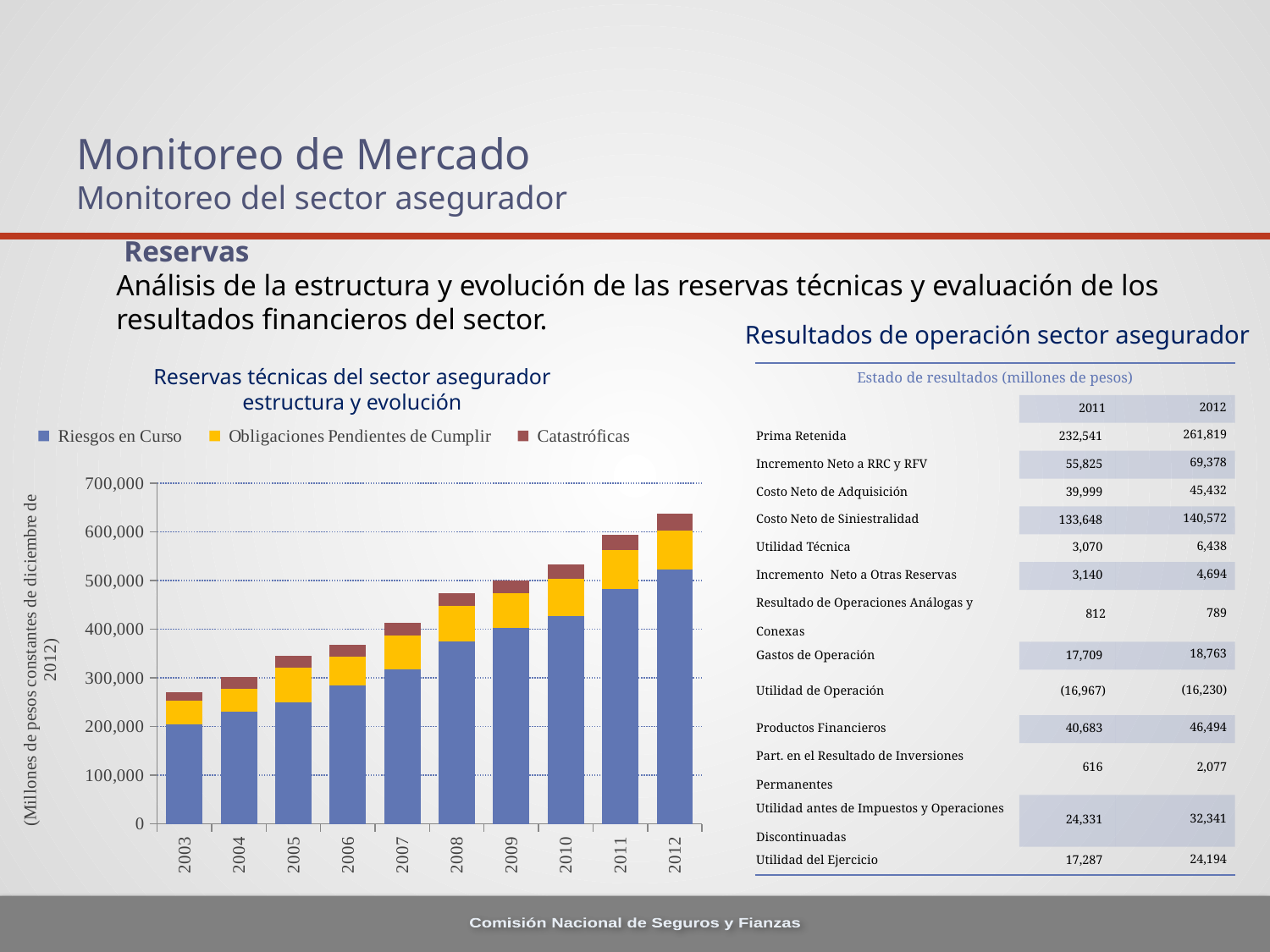
Is the value of Riesgos en Curso for 2011 greater or less than 500,000? less How many years are shown along the x axis of the chart? 10 Which year has a larger total stacked bar, 2006 or 2010? 2010 Which series is shown in yellow in the chart? Obligaciones Pendientes de Cumplir Which year has the tallest stacked bar in the chart? 2012 How many series does the legend of the chart list? 3 Which year has the shortest stacked bar in the chart? 2003 What kind of chart is shown on the slide? Stacked bar chart Do the total technical reserves rise or fall from 2003 to 2012? Rise Is the total stacked bar for 2003 greater or less than 300,000? less Is the value of Riesgos en Curso for 2012 greater or less than 500,000? greater